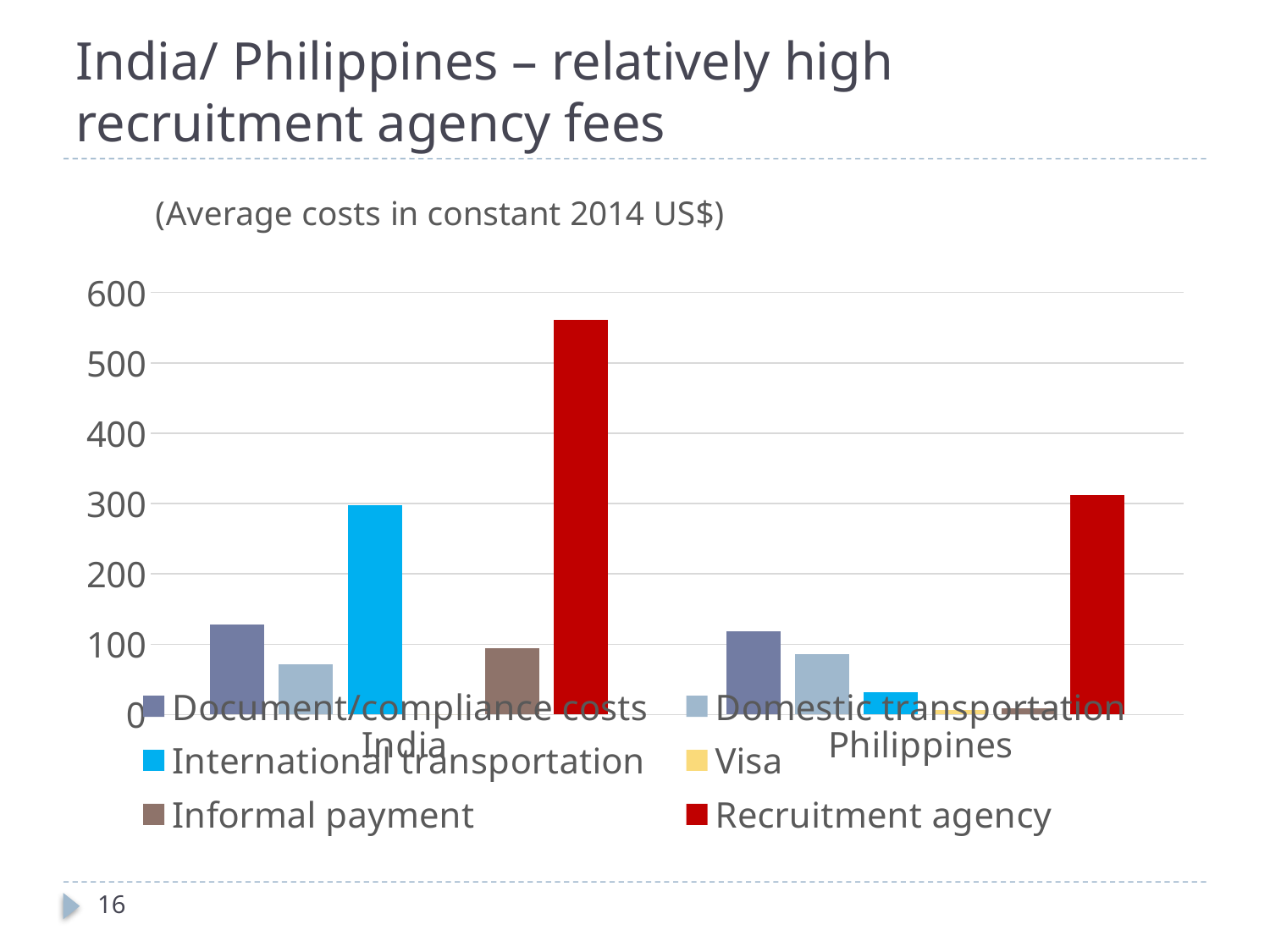
Is the International transportation value for India greater or less than 200? greater How many series does the chart's legend list? 6 What unit does the chart's subtitle say the costs are measured in? constant 2014 US$ Is the International transportation value for the Philippines greater or less than 100? less For India, which cost component has the highest bar? Recruitment agency Is the Recruitment agency value for the Philippines greater or less than 200? greater What kind of chart is shown on the slide? bar chart Which is larger for India: International transportation or Document/compliance costs? International transportation Is the Recruitment agency cost for India larger or smaller than for the Philippines? larger How many countries are shown on the x axis of the chart? 2 For the Philippines, which cost component has the highest bar? Recruitment agency